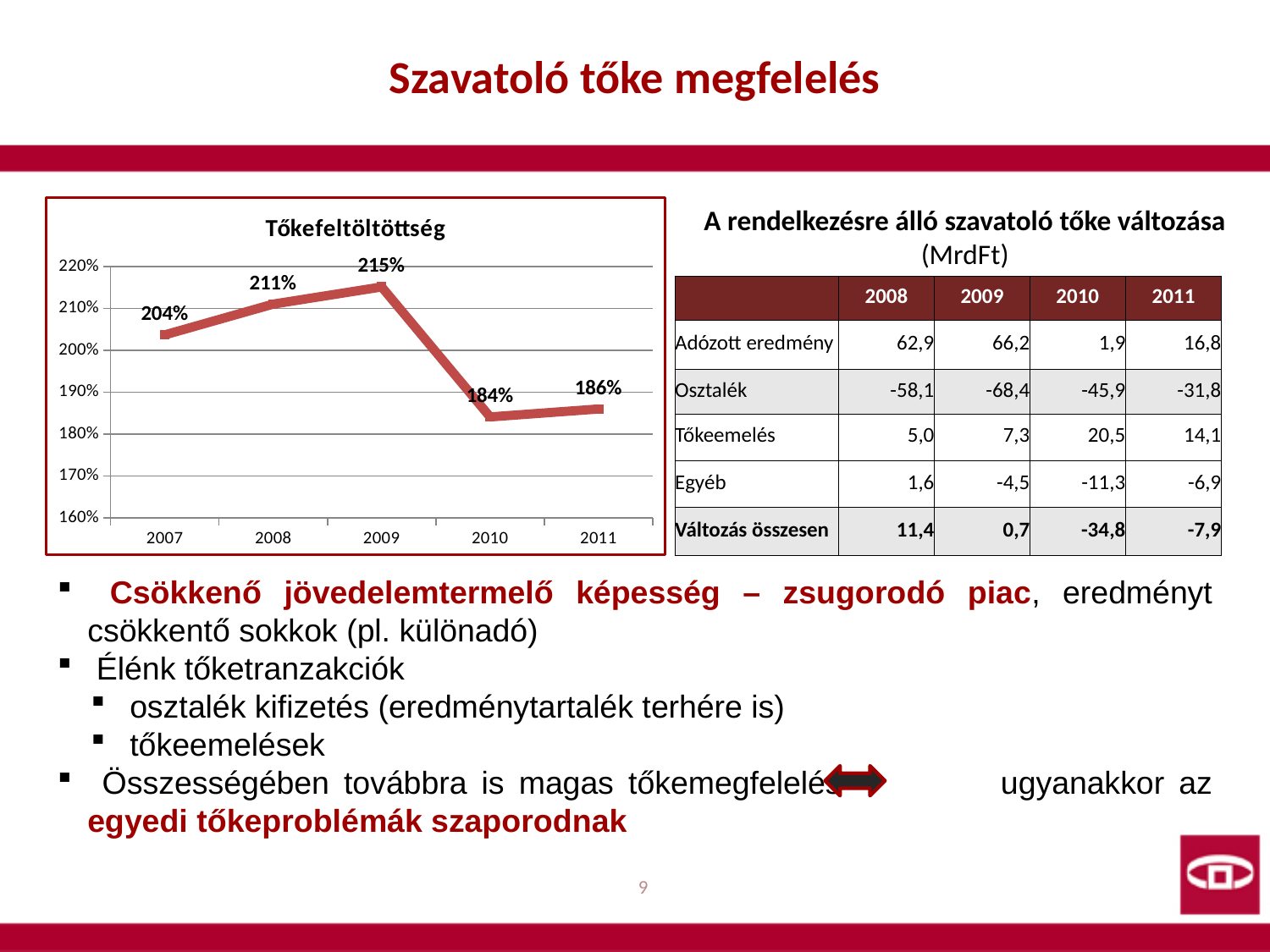
Is the value for 2010 in the Tőkefeltöltöttség chart greater or less than 190%? less What is the value for 2009 in the Tőkefeltöltöttség chart? 215% Which is larger in the Tőkefeltöltöttség chart, the value for 2008 or the value for 2011? 2008 What is the value for 2011 in the Tőkefeltöltöttség chart? 186% Which year has the highest value in the Tőkefeltöltöttség chart? 2009 What kind of chart is the Tőkefeltöltöttség chart? line chart How many years are plotted in the Tőkefeltöltöttség chart? 5 What is the value for 2010 in the Tőkefeltöltöttség chart? 184% Does the value in the Tőkefeltöltöttség chart rise or fall from 2009 to 2010? fall What is the value for 2007 in the Tőkefeltöltöttség chart? 204% Which year has the lowest value in the Tőkefeltöltöttség chart? 2010 What is the difference between the 2009 and 2010 values in the Tőkefeltöltöttség chart? 31 percentage points